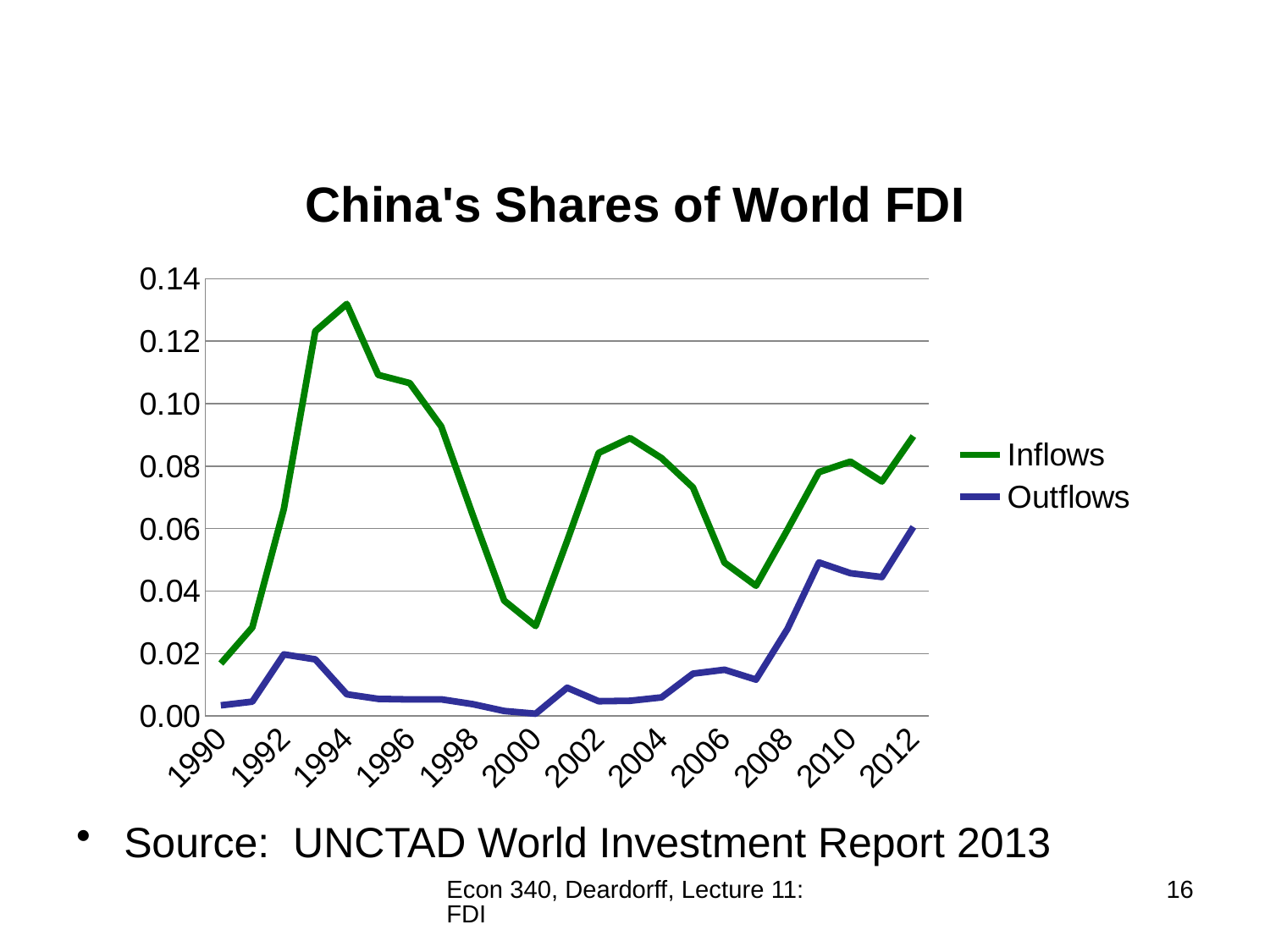
Do the Inflows values rise or fall between 1994 and 2000? fall How many series does the legend list? 2 In which year does the Inflows series reach its highest value? 1994 What is the title of the chart? China's Shares of World FDI What are the two series named in the legend? Inflows and Outflows Is the value for Inflows in 2000 greater or less than 0.04? less In 2012, which series has the larger value, Inflows or Outflows? Inflows In which year does the Outflows series reach its highest value? 2012 Is the value for Inflows in 1994 greater or less than 0.12? greater In which year is the Inflows series at its lowest value? 1990 What kind of chart is shown on the slide? line chart Is the value for Outflows in 2012 greater or less than 0.04? greater